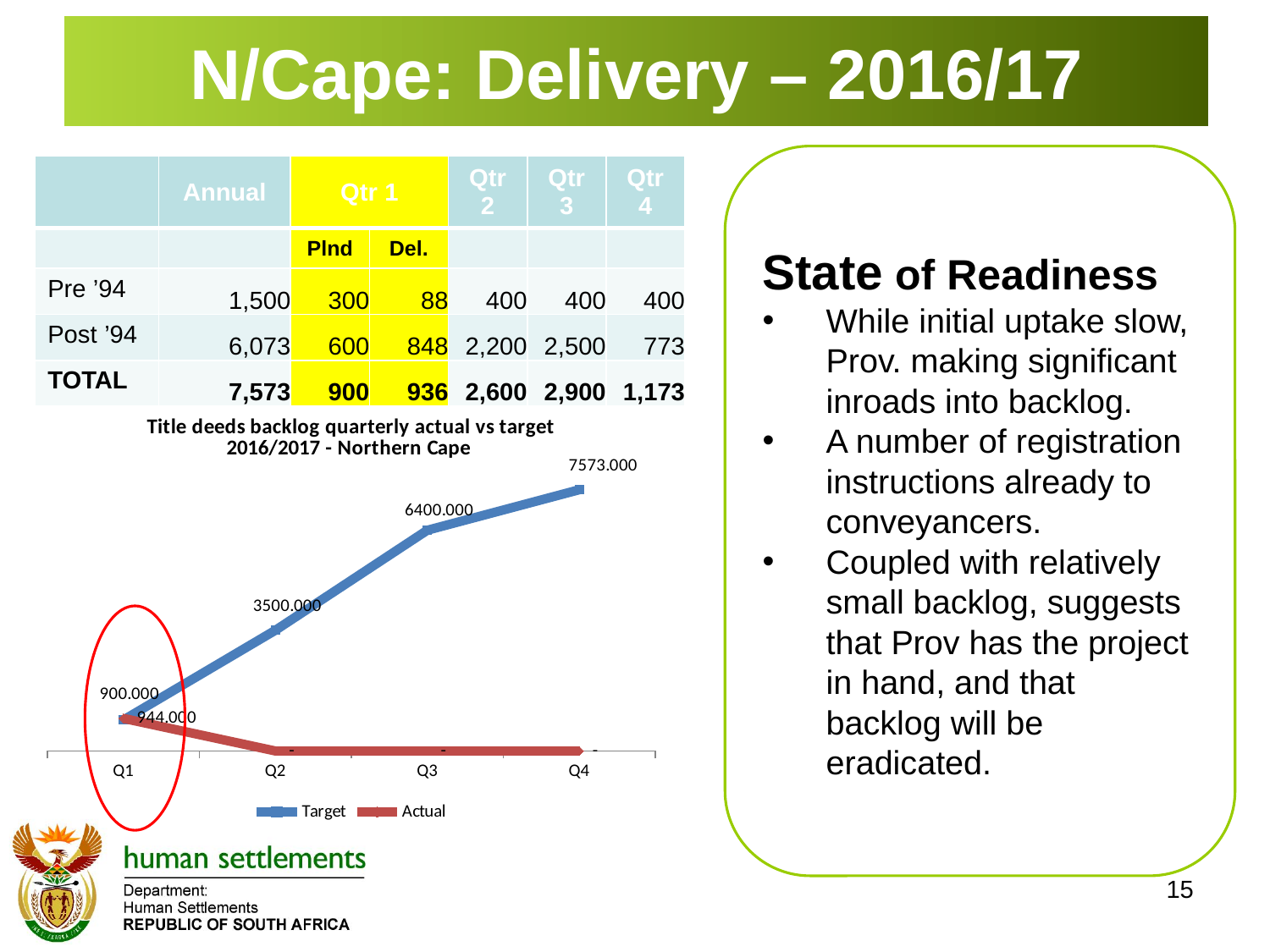
What is the Target value at Q2 in the chart? 3500.000 What is the Actual value at Q1 in the chart? 944.000 What is the Target value at Q4 in the chart? 7573.000 In which quarter is the Target value lowest? Q1 How many quarters are plotted along the x axis of the chart? 4 How many series does the chart legend list? 2 What type of chart is shown on the slide? line chart Does the Target series rise or fall from Q1 to Q4? rise What is the difference between the Target values at Q4 and Q3? 1173.000 What is the title of the chart? Title deeds backlog quarterly actual vs target 2016/2017 - Northern Cape At Q1, which is larger: the Target value or the Actual value? Actual In which quarter is the Target value highest? Q4